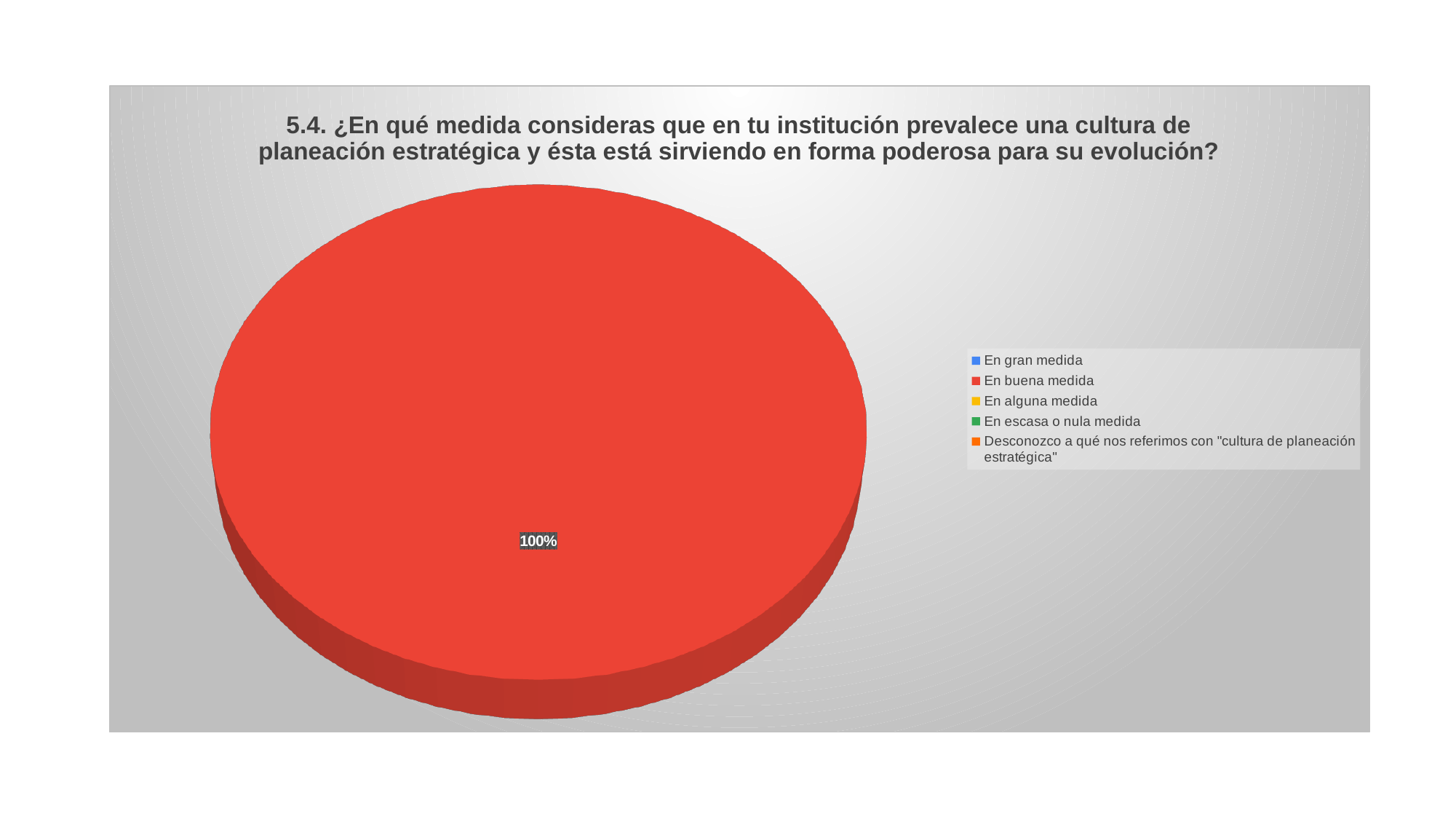
Which category makes up the entire pie? En buena medida Which legend entry corresponds to the red colour? En buena medida Is the share for "En buena medida" greater or less than 50%? greater What colour is the slice labelled 100%? red What is the only data label printed on the pie? 100% What share of the pie does "En buena medida" have? 100% How many categories does the legend list? 5 What kind of chart is shown on the slide? pie chart